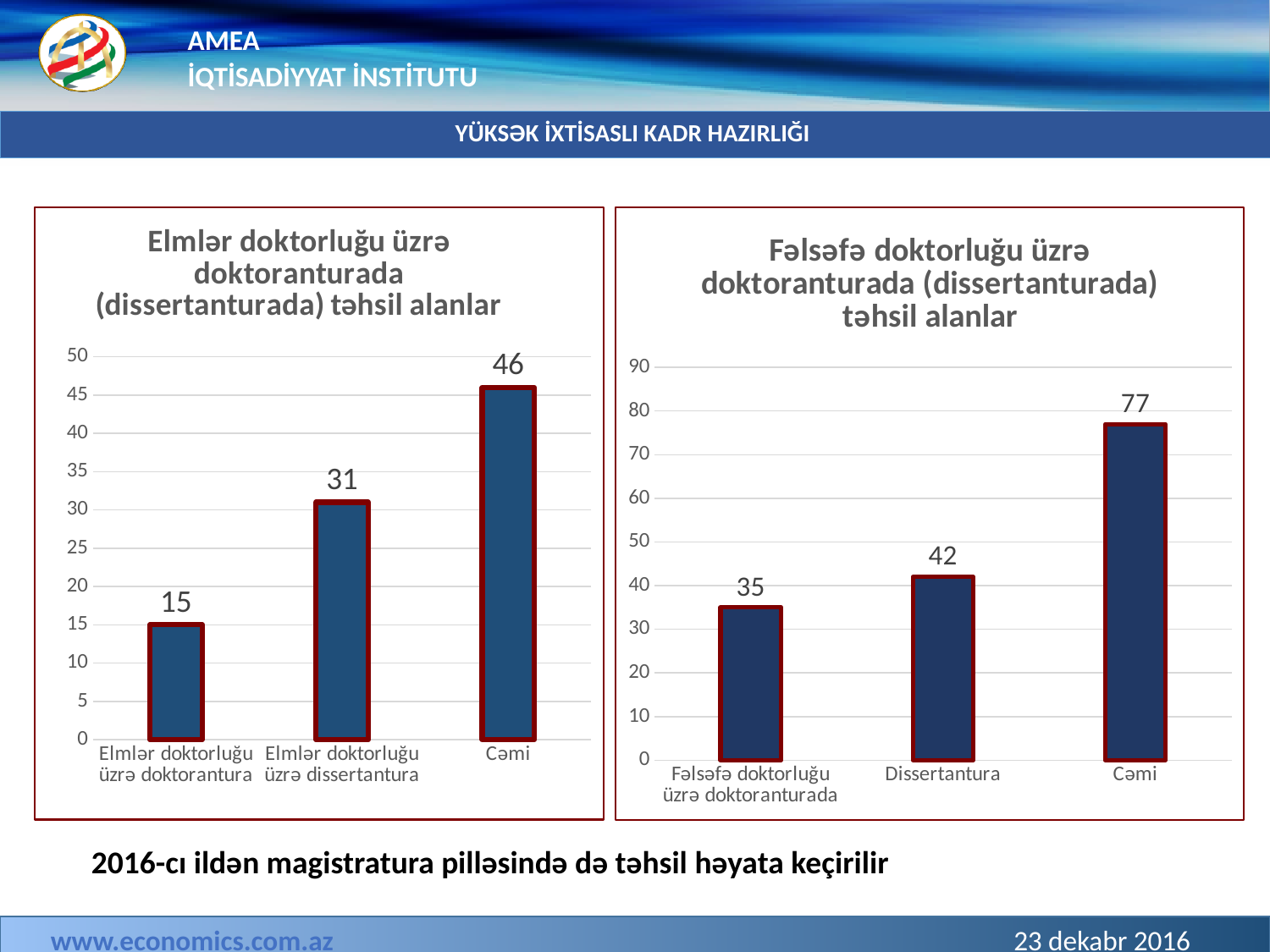
In the right chart (Fəlsəfə doktorluğu üzrə doktoranturada (dissertanturada) təhsil alanlar), what is the value for Cəmi? 77 In the right chart (Fəlsəfə doktorluğu üzrə doktoranturada (dissertanturada) təhsil alanlar), what is the value for Dissertantura? 42 In the right chart (Fəlsəfə doktorluğu üzrə doktoranturada (dissertanturada) təhsil alanlar), which category has the highest value? Cəmi In the right chart (Fəlsəfə doktorluğu üzrə doktoranturada (dissertanturada) təhsil alanlar), what is the value for Fəlsəfə doktorluğu üzrə doktoranturada? 35 In the left chart (Elmlər doktorluğu üzrə doktoranturada (dissertanturada) təhsil alanlar), what is the value for Elmlər doktorluğu üzrə doktorantura? 15 In the left chart (Elmlər doktorluğu üzrə doktoranturada (dissertanturada) təhsil alanlar), what is the value for Cəmi? 46 What kind of chart is the left chart (Elmlər doktorluğu üzrə doktoranturada (dissertanturada) təhsil alanlar)? Bar chart In the left chart (Elmlər doktorluğu üzrə doktoranturada (dissertanturada) təhsil alanlar), which category has the lowest value? Elmlər doktorluğu üzrə doktorantura In the left chart (Elmlər doktorluğu üzrə doktoranturada (dissertanturada) təhsil alanlar), what is the value for Elmlər doktorluğu üzrə dissertantura? 31 In the left chart (Elmlər doktorluğu üzrə doktoranturada (dissertanturada) təhsil alanlar), what is the difference between the values for Elmlər doktorluğu üzrə dissertantura and Elmlər doktorluğu üzrə doktorantura? 16 How many categories are shown in the right chart (Fəlsəfə doktorluğu üzrə doktoranturada (dissertanturada) təhsil alanlar)? 3 In the right chart (Fəlsəfə doktorluğu üzrə doktoranturada (dissertanturada) təhsil alanlar), which is larger: the value for Dissertantura or the value for Fəlsəfə doktorluğu üzrə doktoranturada? Dissertantura